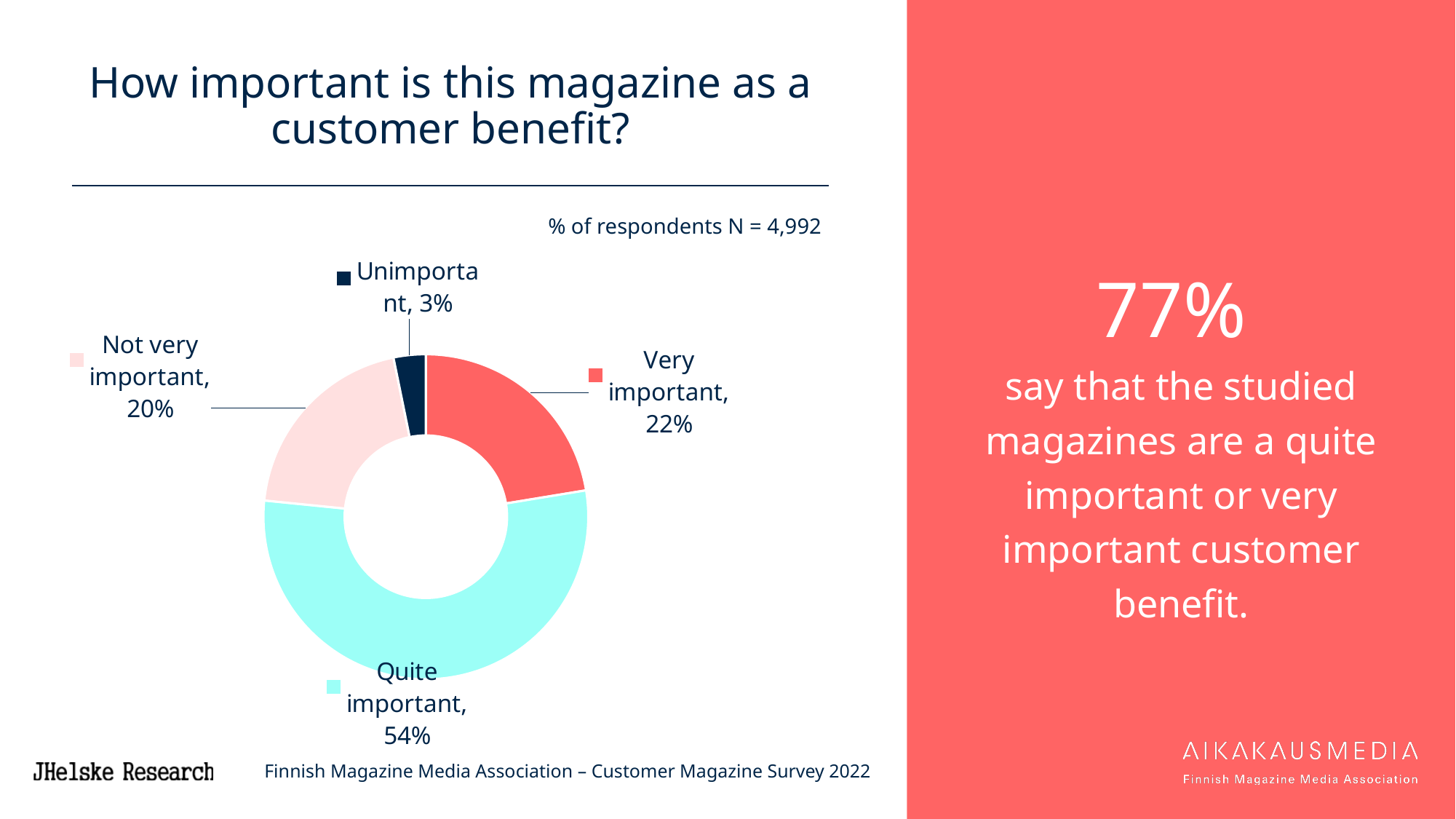
How many respondents (N) does the chart note say took part? 4,992 Which category has the smallest share of respondents? Unimportant What kind of chart is shown on the slide? Pie chart (doughnut) What percentage of respondents say the magazine is unimportant? 3% What percentage of respondents say the magazine is very important as a customer benefit? 22% How many categories are shown in the chart? 4 What percentage of respondents say the magazine is quite important as a customer benefit? 54% Which category has the largest share of respondents? Quite important What percentage of respondents say the magazine is not very important? 20% What is the difference in percentage points between 'Quite important' and 'Very important'? 32 What is the combined share of respondents who say the magazine is quite important or very important? 77% Which is larger: the share for 'Very important' or the share for 'Not very important'? Very important